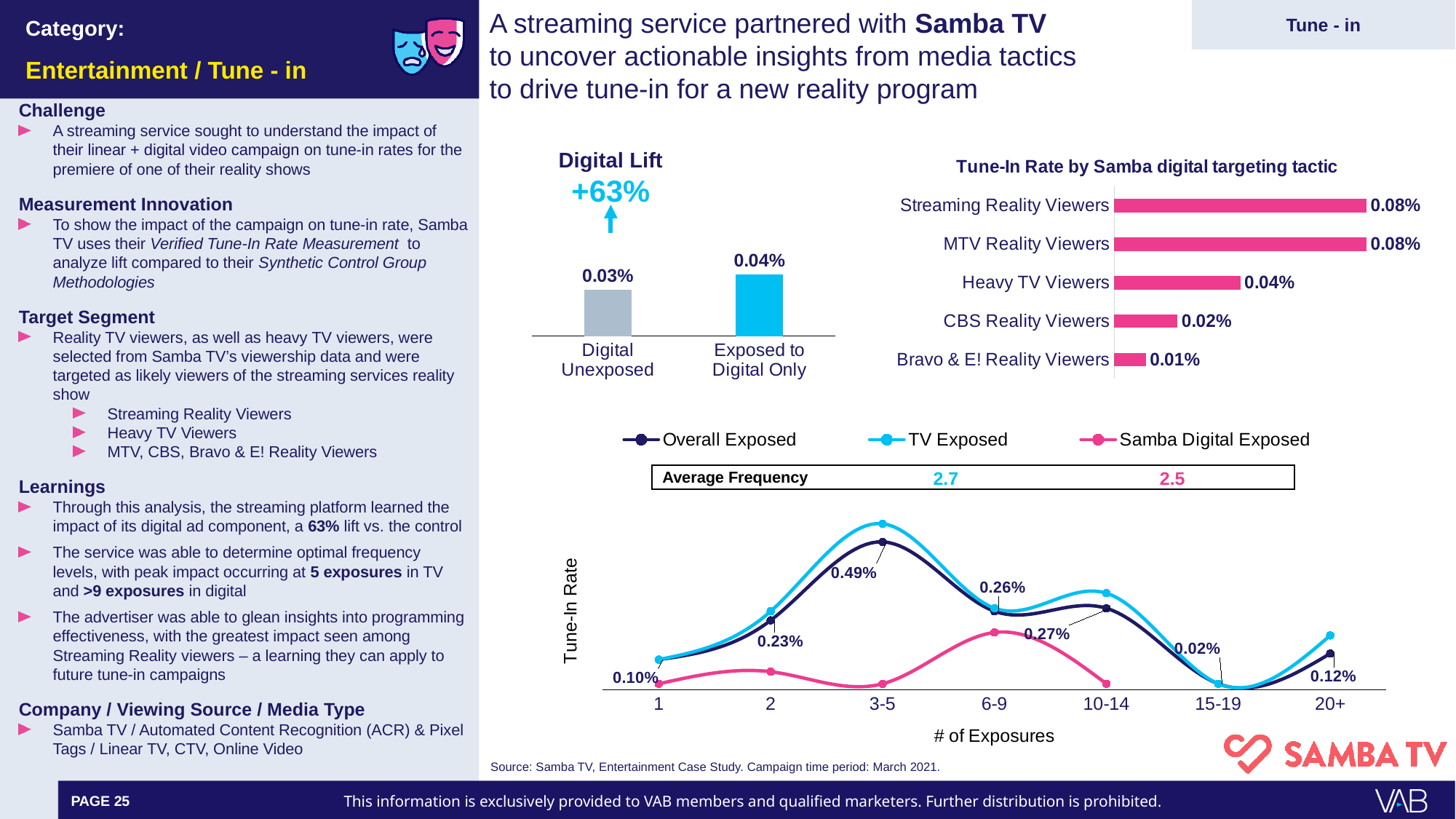
In the line chart at the bottom right, how many exposure categories are shown on the x axis? 7 In the Tune-In Rate by Samba digital targeting tactic chart, what is the value for CBS Reality Viewers? 0.02% In the Tune-In Rate by Samba digital targeting tactic chart, which is larger: Heavy TV Viewers or CBS Reality Viewers? Heavy TV Viewers In the Tune-In Rate by Samba digital targeting tactic chart, what is the difference between Streaming Reality Viewers and Heavy TV Viewers? 0.04% In the Digital Lift chart, what is the difference between Exposed to Digital Only and Digital Unexposed? 0.01% In the Digital Lift chart, what is the value for Exposed to Digital Only? 0.04% In the Digital Lift chart, what is the value for Digital Unexposed? 0.03% In the Tune-In Rate by Samba digital targeting tactic chart, which category has the lowest value? Bravo & E! Reality Viewers In the Digital Lift chart, what lift percentage is shown above the bars? +63% In the Tune-In Rate by Samba digital targeting tactic chart, what is the value for Heavy TV Viewers? 0.04% In the line chart at the bottom right, how many series does the legend list? 3 In the Tune-In Rate by Samba digital targeting tactic chart, how many categories are shown? 5